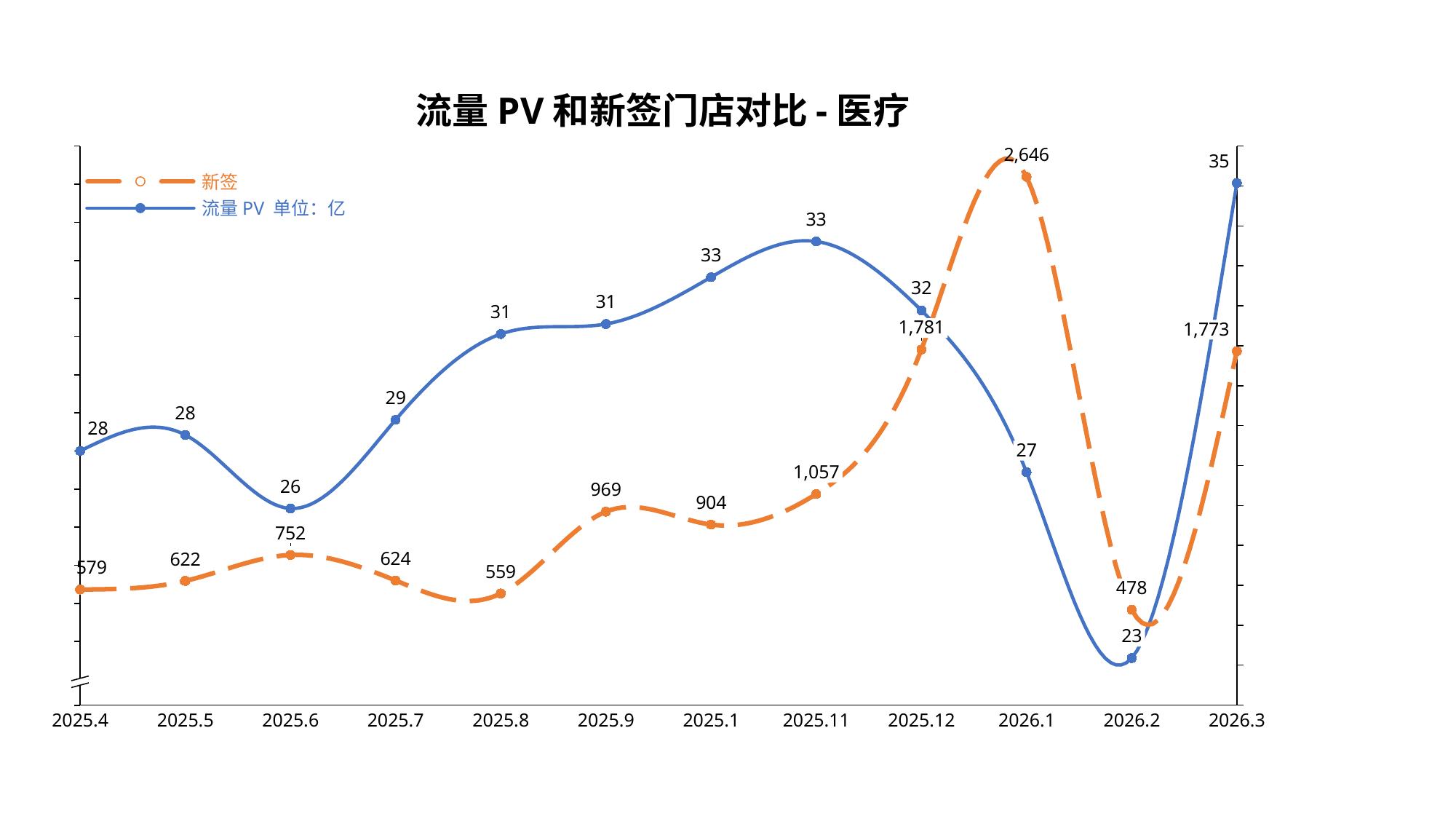
Which x-axis category has the highest 新签 value? 2026.1 What is the difference between the 新签 values for 2026.1 and 2026.2? 2,168 What is the 新签 value for 2026.1? 2,646 Which is larger, the 新签 value for 2025.9 or for 2025.1? 2025.9 What is the 流量 PV value for 2025.7? 29 How many x-axis categories are plotted on the chart? 12 What kind of chart is shown on the slide? Line chart How many series does the legend list? 2 Which x-axis category has the lowest 流量 PV value? 2026.2 What is the difference between the 流量 PV values for 2026.3 and 2026.2? 12 What is the 新签 value for 2025.11? 1,057 Which x-axis category has the lowest 新签 value? 2026.2